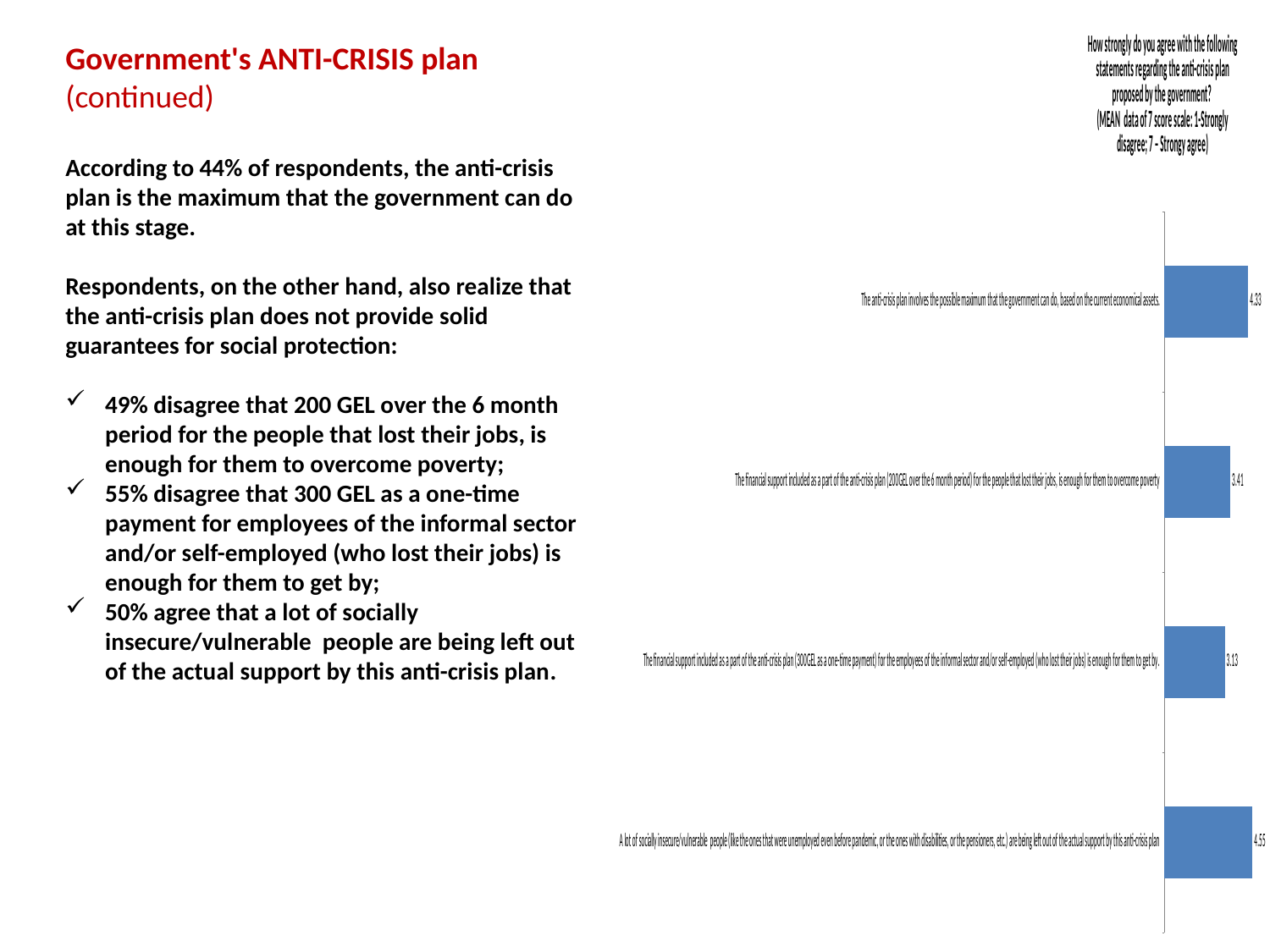
What is the mean score for the statement that the anti-crisis plan involves the possible maximum that the government can do? 4.33 What is the difference between the highest mean score (4.55) and the lowest mean score (3.13) in the chart? 1.42 Which statement has the lowest mean score in the chart? The 300 GEL one-time payment for employees of the informal sector and/or self-employed is enough for them to get by What is the difference between the mean score for the 'possible maximum' statement and the mean score for the '200 GEL over 6 months' statement? 0.92 What is the mean score for the statement that a lot of socially insecure/vulnerable people are being left out of the actual support by the anti-crisis plan? 4.55 What is the mean score for the statement that the 300 GEL one-time payment for informal sector/self-employed workers is enough for them to get by? 3.13 What type of chart is shown on the slide? Bar chart According to the chart title, what scale are the mean scores based on? 7 score scale: 1-Strongly disagree; 7-Strongly agree What is the mean score for the statement that 200 GEL over the 6 month period is enough for people who lost their jobs to overcome poverty? 3.41 How many statements (categories) are plotted in the chart? 4 Which statement has the highest mean score in the chart? A lot of socially insecure/vulnerable people are being left out of the actual support by this anti-crisis plan Which has a higher mean score: the statement about the 200 GEL support over 6 months or the statement about the 300 GEL one-time payment? The 200 GEL over 6 months statement